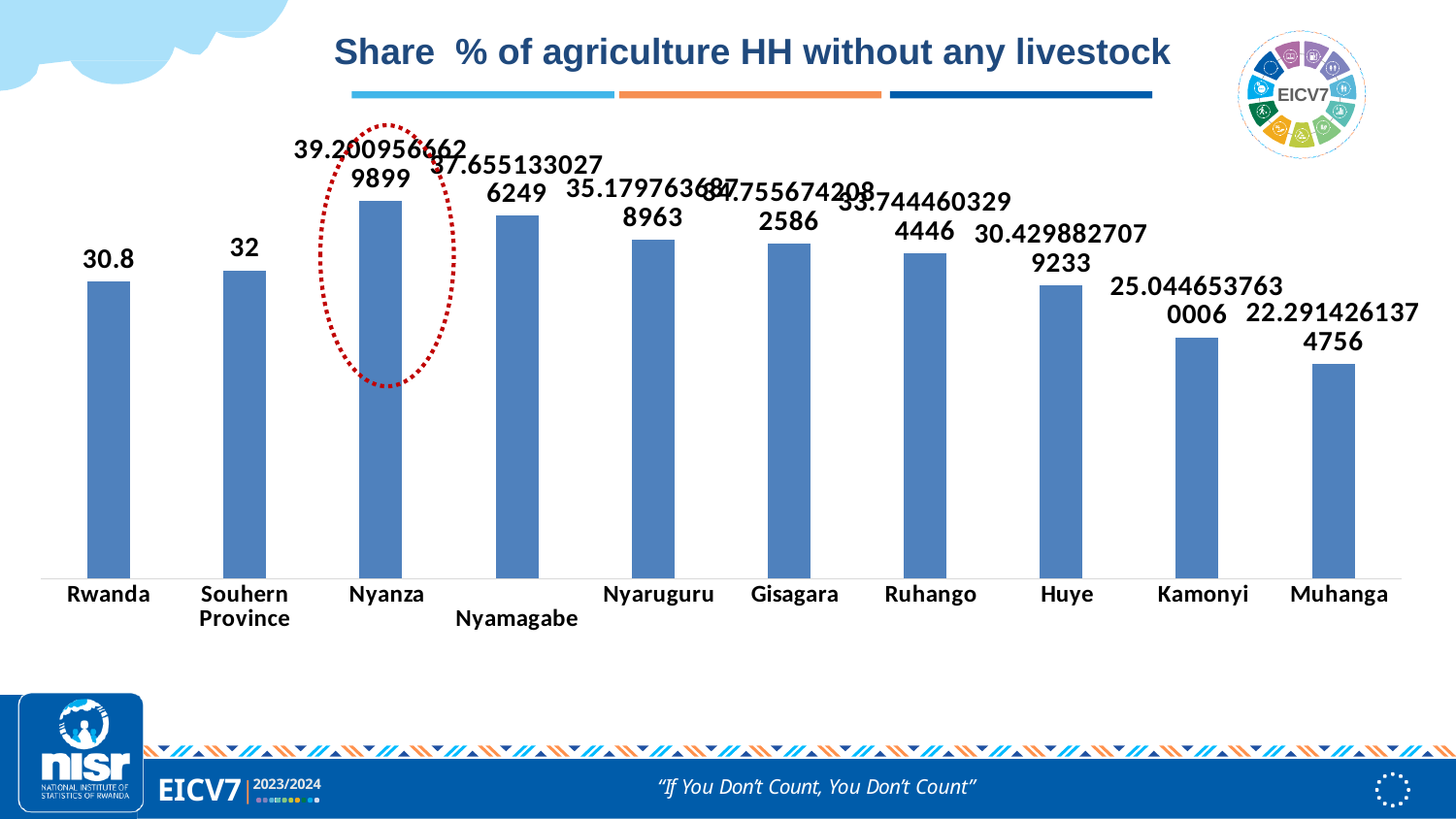
Which category has the lowest value? Muhanga What is the value for Souhern Province? 32 What kind of chart is shown on the slide? Bar chart Which category has the highest value? Nyanza What is the difference between the values for Souhern Province and Rwanda? 1.2 How many categories are shown on the x axis? 10 What is the value shown for Huye? 30.4298827079233 What is the value shown for Kamonyi? 25.0446537630006 What is the value shown for Muhanga? 22.2914261374756 What is the value for Rwanda? 30.8 Which bar is highlighted with a red dotted circle? Nyanza Which has a larger value, Kamonyi or Muhanga? Kamonyi